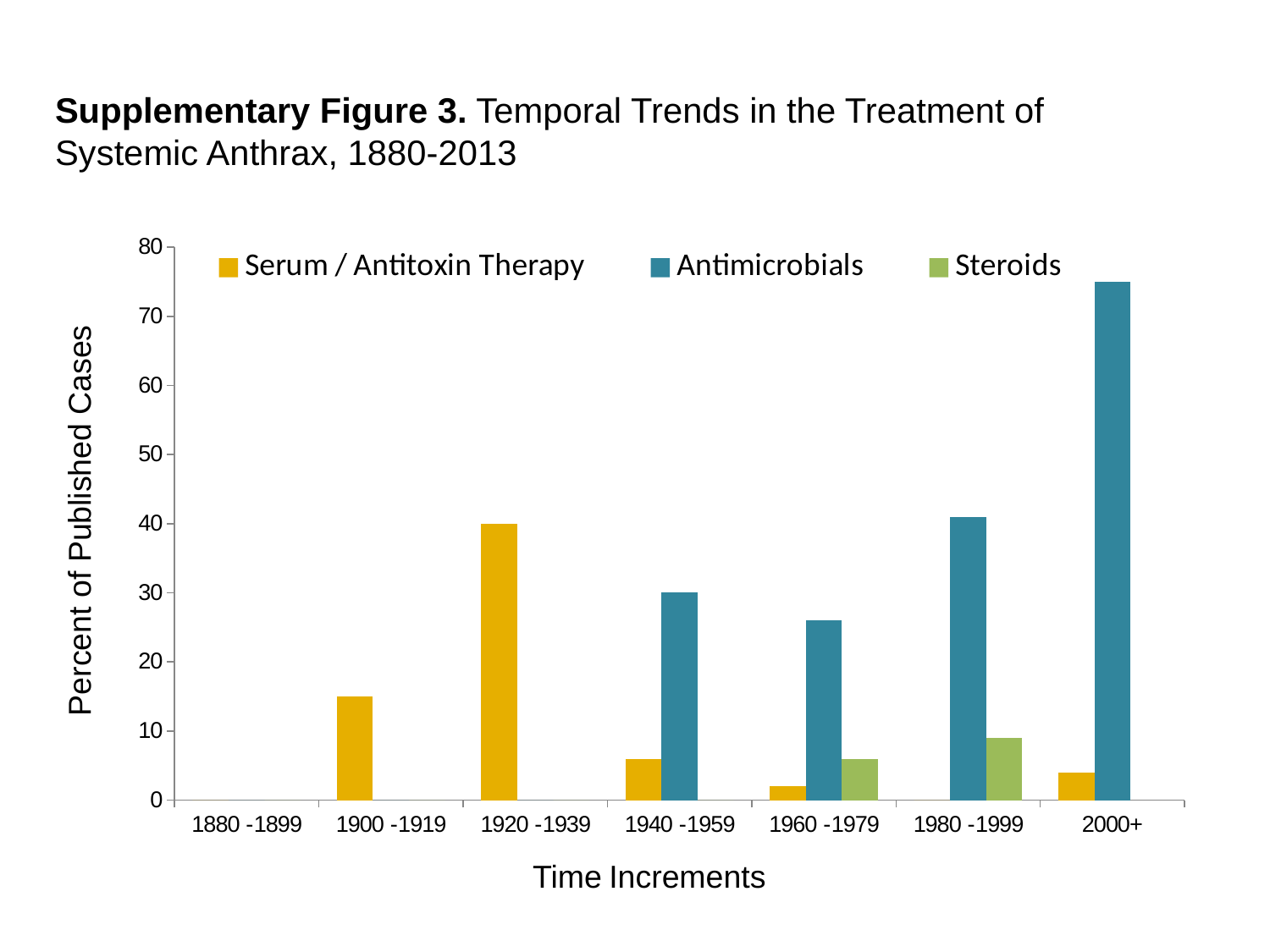
Which is larger in 1980 -1999: Antimicrobials or Steroids? Antimicrobials What is the value for Serum / Antitoxin Therapy in 1920 -1939? 40 How many time increments are shown on the x axis? 7 What is the value for Antimicrobials in 1940 -1959? 30 What is the label of the y axis? Percent of Published Cases In which time increment is the Antimicrobials value highest? 2000+ Is the value for Serum / Antitoxin Therapy in 1900 -1919 greater or less than 20? less Does the Antimicrobials value rise or fall from 1980 -1999 to 2000+? rise What type of chart is shown on the slide? bar chart How many series does the legend list? 3 Is the value for Antimicrobials in 2000+ greater or less than 70? greater In which time increment is the Serum / Antitoxin Therapy value highest? 1920 -1939